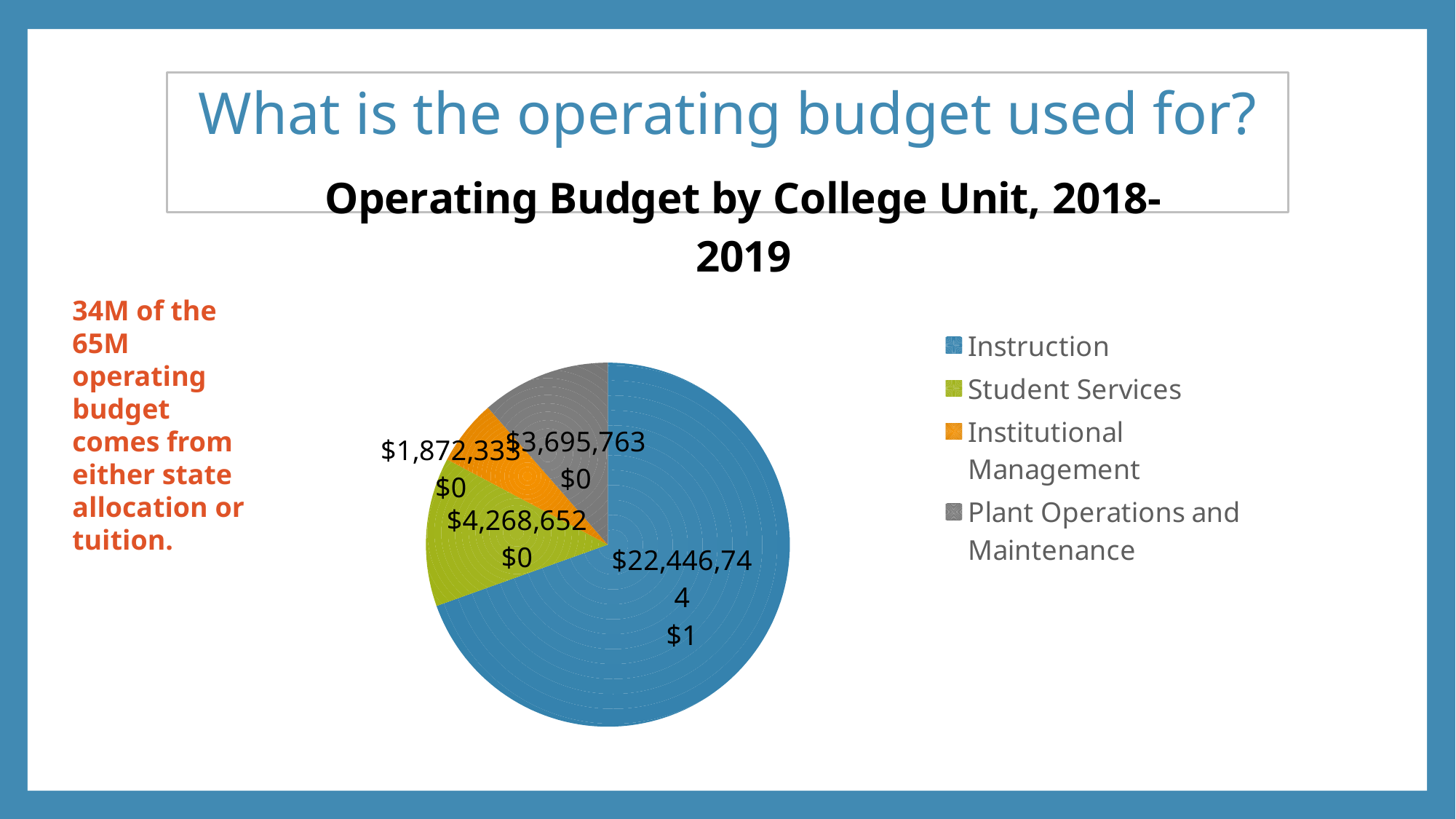
What is the difference between the Instruction value and the Student Services value? $18,178,092 What kind of chart is shown on the slide? pie chart What is the value for Plant Operations and Maintenance in the pie chart? $3,695,763 What is the value for Instruction in the pie chart? $22,446,744 What is the difference between the Student Services value and the Plant Operations and Maintenance value? $572,889 Which is larger, the value for Student Services or the value for Plant Operations and Maintenance? Student Services How many slices does the pie chart have? 4 What is the value for Student Services in the pie chart? $4,268,652 What colour is the Instruction slice in the pie chart? blue Which college unit has the smallest slice of the pie chart? Institutional Management What is the title of the chart? Operating Budget by College Unit, 2018-2019 Which college unit has the largest share of the operating budget? Instruction